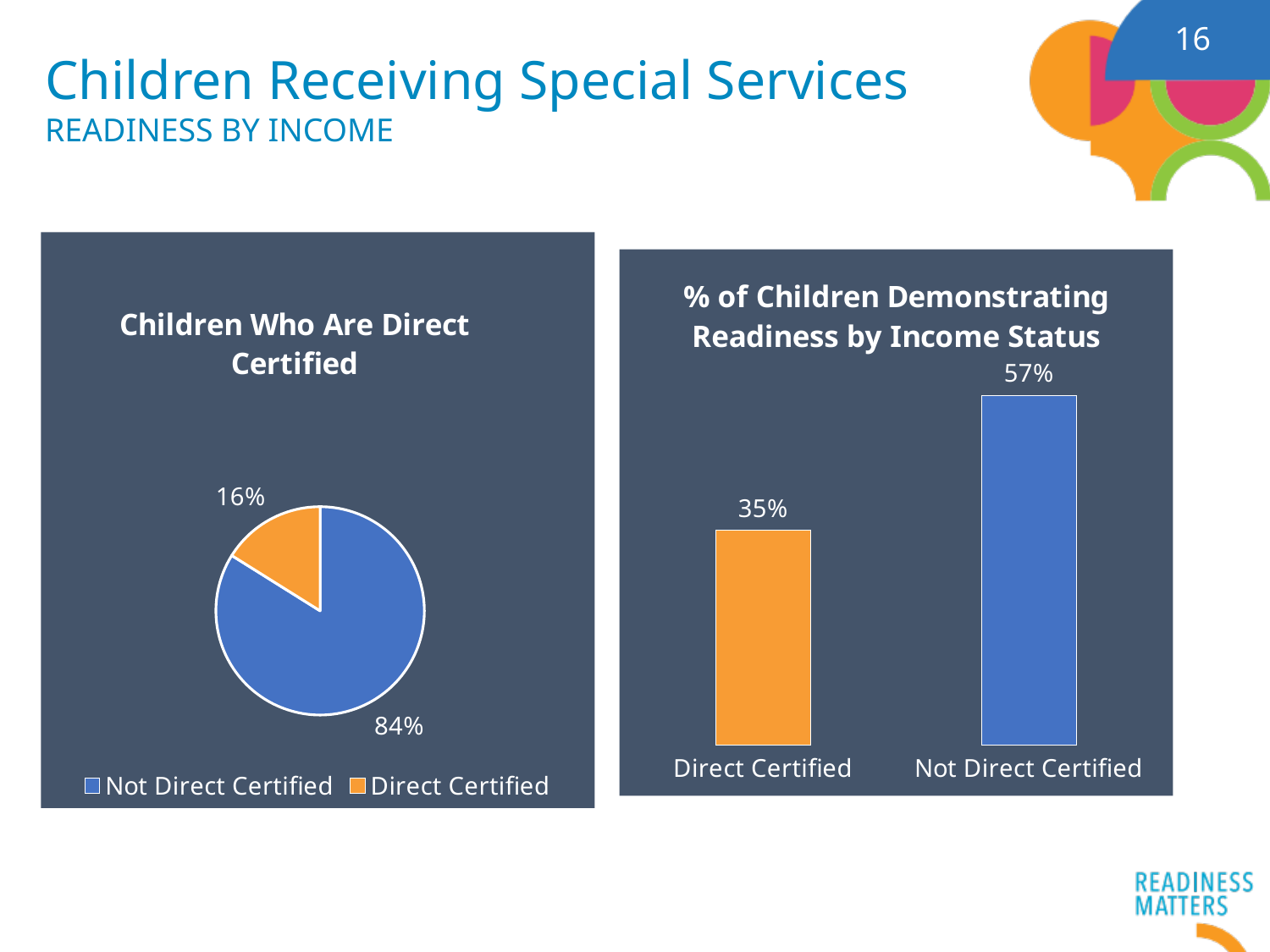
In the '% of Children Demonstrating Readiness by Income Status' chart, what is the difference between Not Direct Certified and Direct Certified? 22% In the '% of Children Demonstrating Readiness by Income Status' chart, what is the value for Not Direct Certified? 57% How many entries does the legend of the 'Children Who Are Direct Certified' chart list? 2 In the 'Children Who Are Direct Certified' chart, what share of children are Direct Certified? 16% What kind of chart is 'Children Who Are Direct Certified'? Pie chart In the '% of Children Demonstrating Readiness by Income Status' chart, which category has the highest value? Not Direct Certified What kind of chart is '% of Children Demonstrating Readiness by Income Status'? Bar chart In the 'Children Who Are Direct Certified' chart, what share of children are Not Direct Certified? 84% In the 'Children Who Are Direct Certified' chart, what colour is the Direct Certified slice? Orange How many categories are shown in the '% of Children Demonstrating Readiness by Income Status' chart? 2 In the 'Children Who Are Direct Certified' chart, which slice is larger, Not Direct Certified or Direct Certified? Not Direct Certified In the '% of Children Demonstrating Readiness by Income Status' chart, what is the value for Direct Certified? 35%